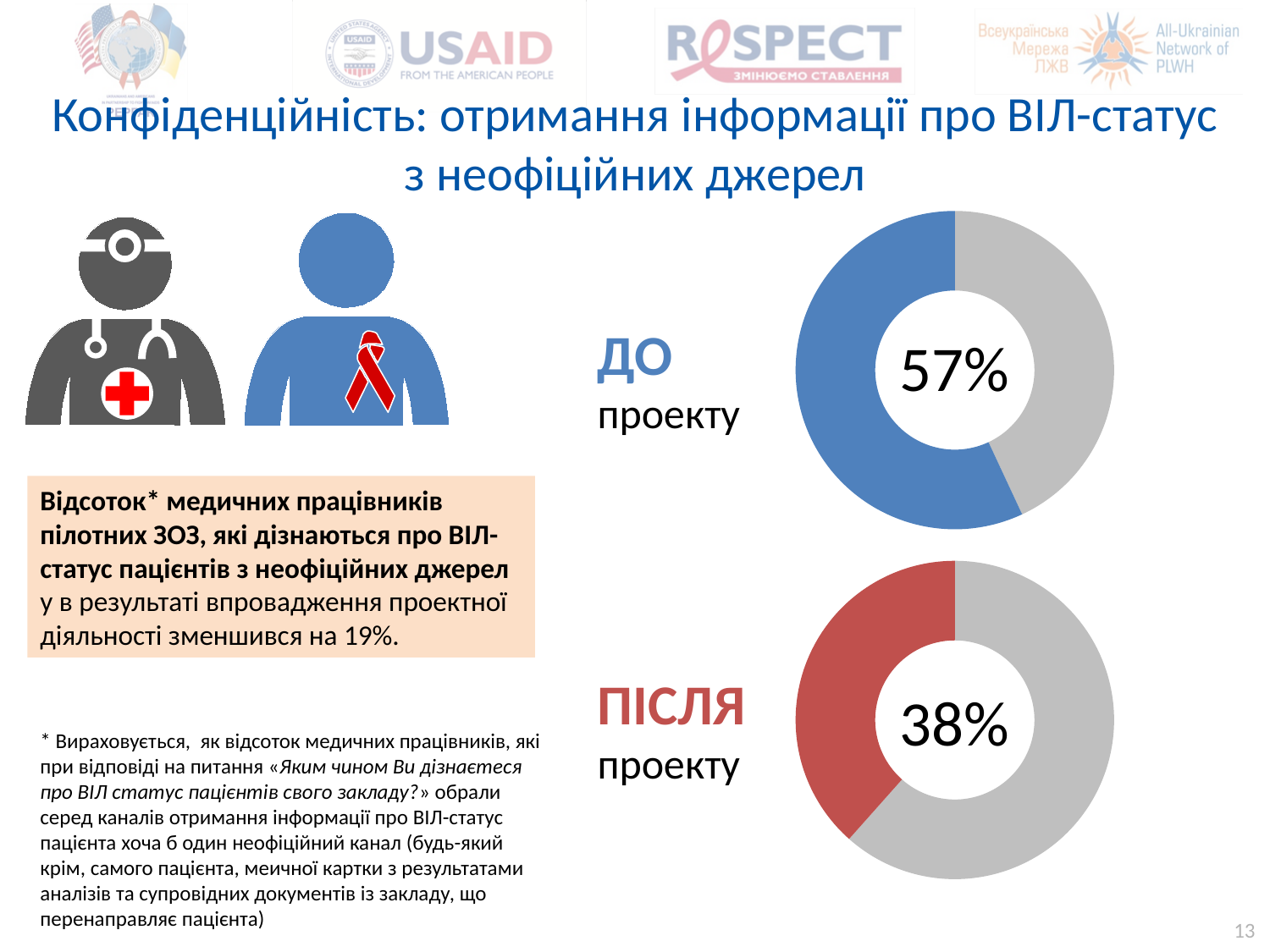
In the 'ДО проекту' chart, is the value greater or less than 50%? greater What colour is the highlighted segment in the 'ДО проекту' donut chart? Blue In the 'ПІСЛЯ проекту' donut chart, what percentage is shown in the centre? 38% What is the difference between the percentage in the 'ДО проекту' chart and the percentage in the 'ПІСЛЯ проекту' chart? 19% Did the percentage of medical workers learning HIV status from unofficial sources rise or fall from 'ДО проекту' to 'ПІСЛЯ проекту'? fall What kind of chart is used to show the 'ДО проекту' and 'ПІСЛЯ проекту' values? Donut chart Which chart shows the larger percentage, 'ДО проекту' or 'ПІСЛЯ проекту'? ДО проекту In the 'ДО проекту' donut chart, what percentage is shown in the centre? 57% What colour is the highlighted segment in the 'ПІСЛЯ проекту' donut chart? Red In the 'ПІСЛЯ проекту' chart, is the value greater or less than 50%? less How many donut charts are on the slide? 2 In the 'ДО проекту' donut chart, what share of the ring does the blue segment represent? 57%